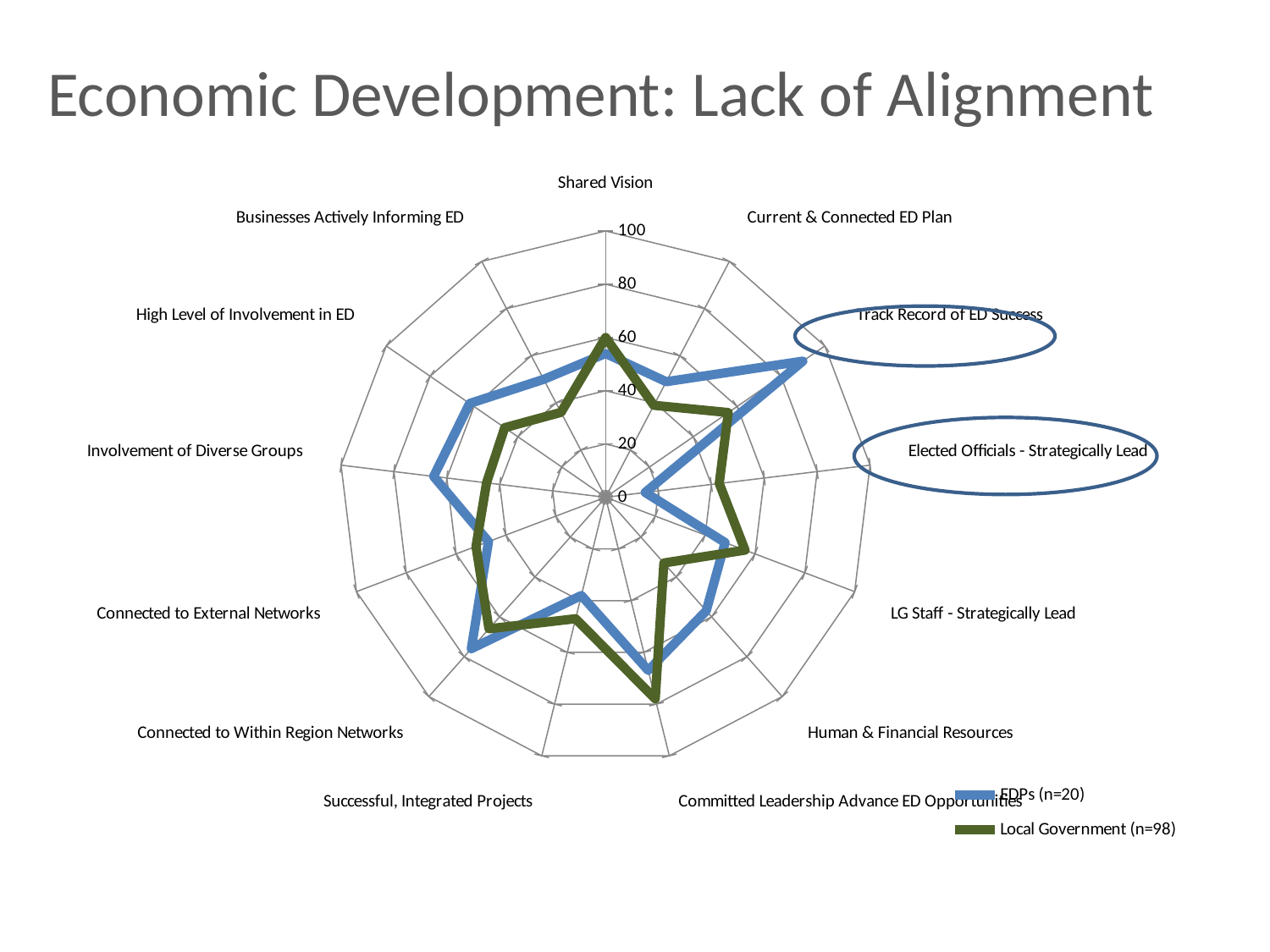
What kind of chart is shown on the slide? Radar chart For Involvement of Diverse Groups, which series has the larger value, EDPs (n=20) or Local Government (n=98)? EDPs (n=20) What are the two series named in the legend? EDPs (n=20) and Local Government (n=98) Is the EDPs (n=20) value for Elected Officials - Strategically Lead greater or less than 20? less How many categories (axes) does the radar chart have? 13 Is the EDPs (n=20) value for Track Record of ED Success greater or less than 80? greater For which category is the EDPs (n=20) value lowest? Elected Officials - Strategically Lead How many series does the legend list? 2 For which category is the EDPs (n=20) value highest? Track Record of ED Success For which category is the Local Government (n=98) value highest? Committed Leadership Advance ED Opportunities What is the title of the slide containing the chart? Economic Development: Lack of Alignment For Elected Officials - Strategically Lead, which series has the larger value, EDPs (n=20) or Local Government (n=98)? Local Government (n=98)